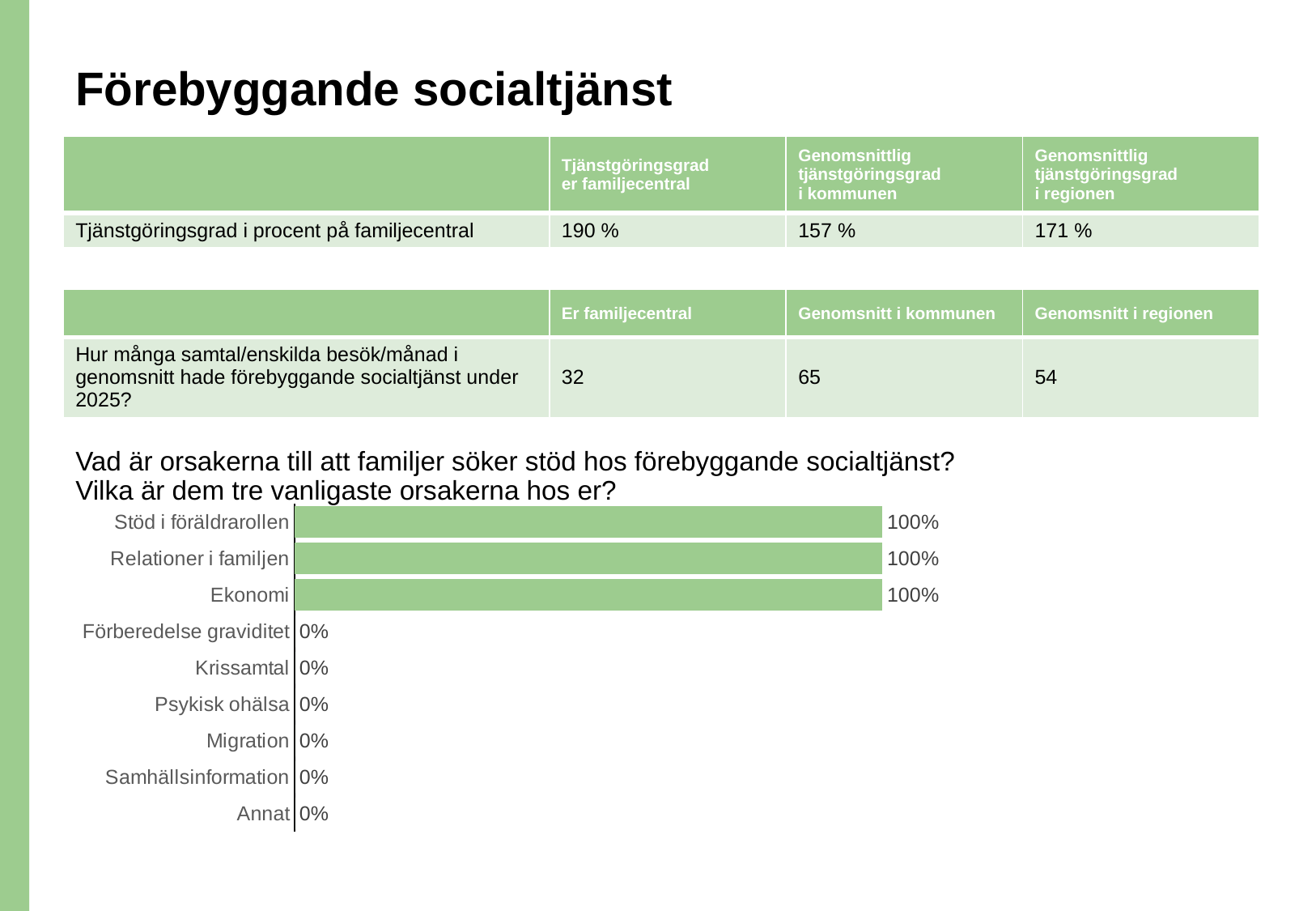
What is the value for Migration in the bar chart? 0% How many categories does the bar chart show? 9 Which category is listed first (at the top) in the bar chart? Stöd i föräldrarollen What kind of chart is shown on the slide? bar chart How many categories in the bar chart have a value of 0%? 6 Which is larger in the bar chart, Ekonomi or Psykisk ohälsa? Ekonomi How many categories in the bar chart have a value of 100%? 3 What is the value for Stöd i föräldrarollen in the bar chart? 100% What is the value for Ekonomi in the bar chart? 100% What is the difference between the values for Stöd i föräldrarollen and Annat in the bar chart? 100% What is the value for Krissamtal in the bar chart? 0% What is the value for Relationer i familjen in the bar chart? 100%